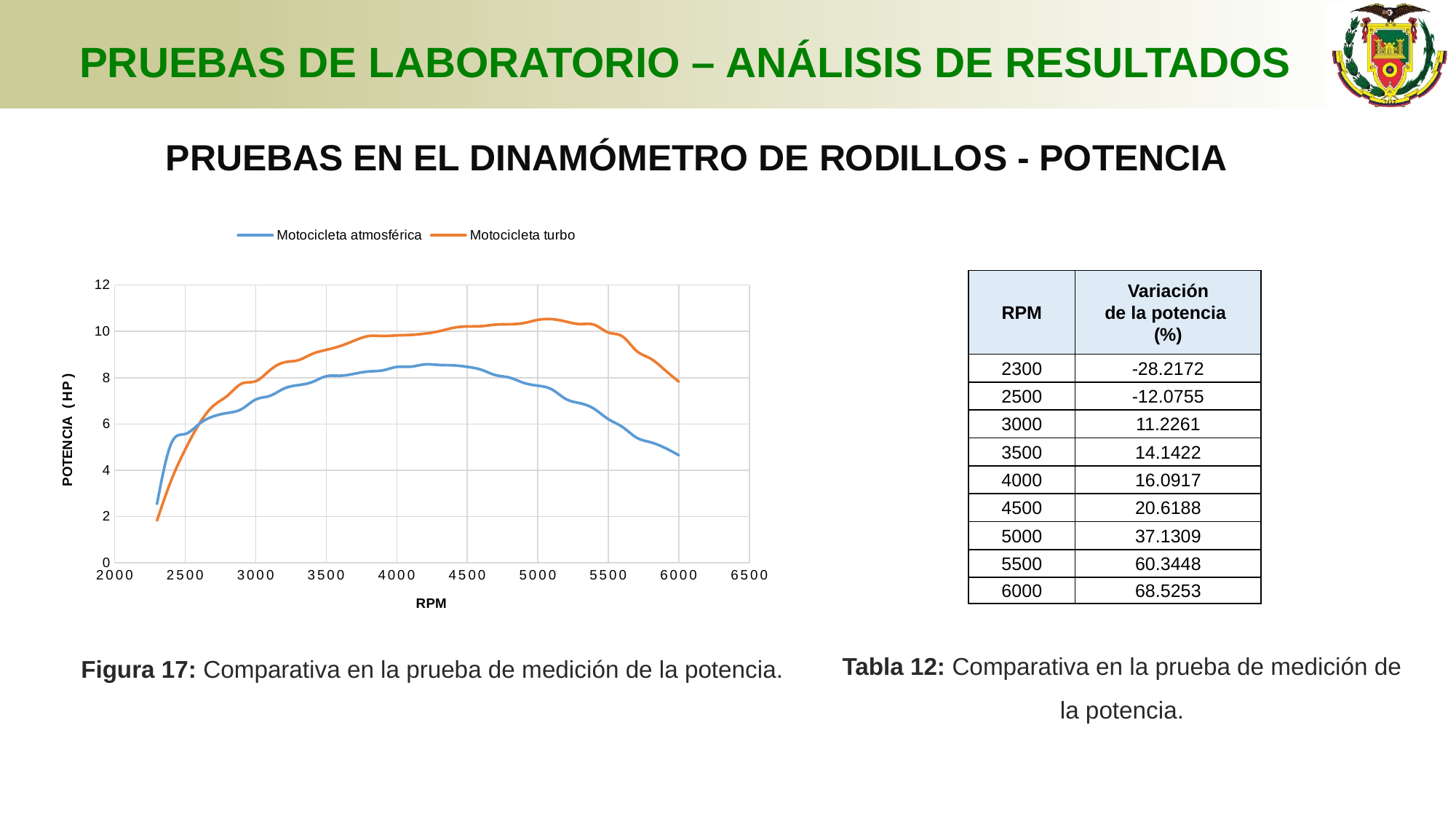
Is the value for Motocicleta turbo at 5000 RPM greater or less than 10? greater How many series does the legend of the chart list? 2 What kind of chart is shown in Figura 17? line chart Is the value for Motocicleta atmosférica at 6000 RPM greater or less than 6? less At the lowest RPM plotted (around 2300), which series has the higher power value? Motocicleta atmosférica Which series reaches the higher peak power in the chart? Motocicleta turbo What are the two series named in the chart legend? Motocicleta atmosférica and Motocicleta turbo At 5000 RPM, which series has the higher power value? Motocicleta turbo Is the value for Motocicleta turbo at 3000 RPM greater or less than 6? greater What is the label of the vertical axis of the chart? POTENCIA (HP) Does the Motocicleta atmosférica line rise or fall between 4500 and 6000 RPM? fall Does the Motocicleta turbo line rise or fall between 2500 and 4000 RPM? rise